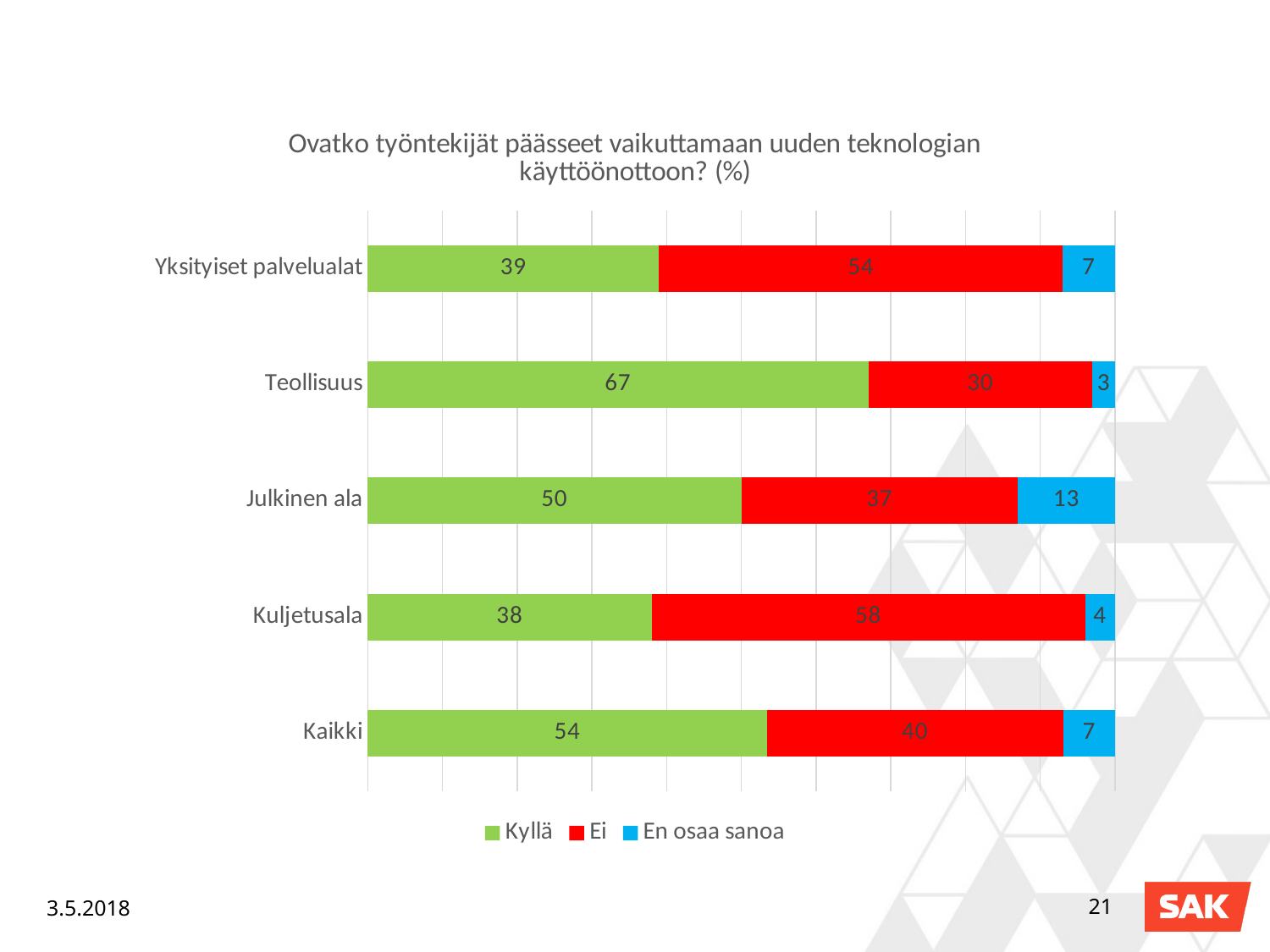
What is the total of the stacked bar for Julkinen ala? 100 How many categories are shown on the chart? 5 Which colour represents the Ei series? Red Which category has the lowest Ei value? Teollisuus Which category has the highest Kyllä value? Teollisuus What is the Ei value for Kuljetusala? 58 What is the Kyllä value for Teollisuus? 67 What kind of chart is shown on the slide? Stacked bar chart What is the difference between the Ei value for Kuljetusala and the Ei value for Yksityiset palvelualat? 4 What is the En osaa sanoa value for Julkinen ala? 13 Which is larger: the Kyllä value for Kaikki or the Kyllä value for Julkinen ala? Kaikki How many series does the legend list? 3